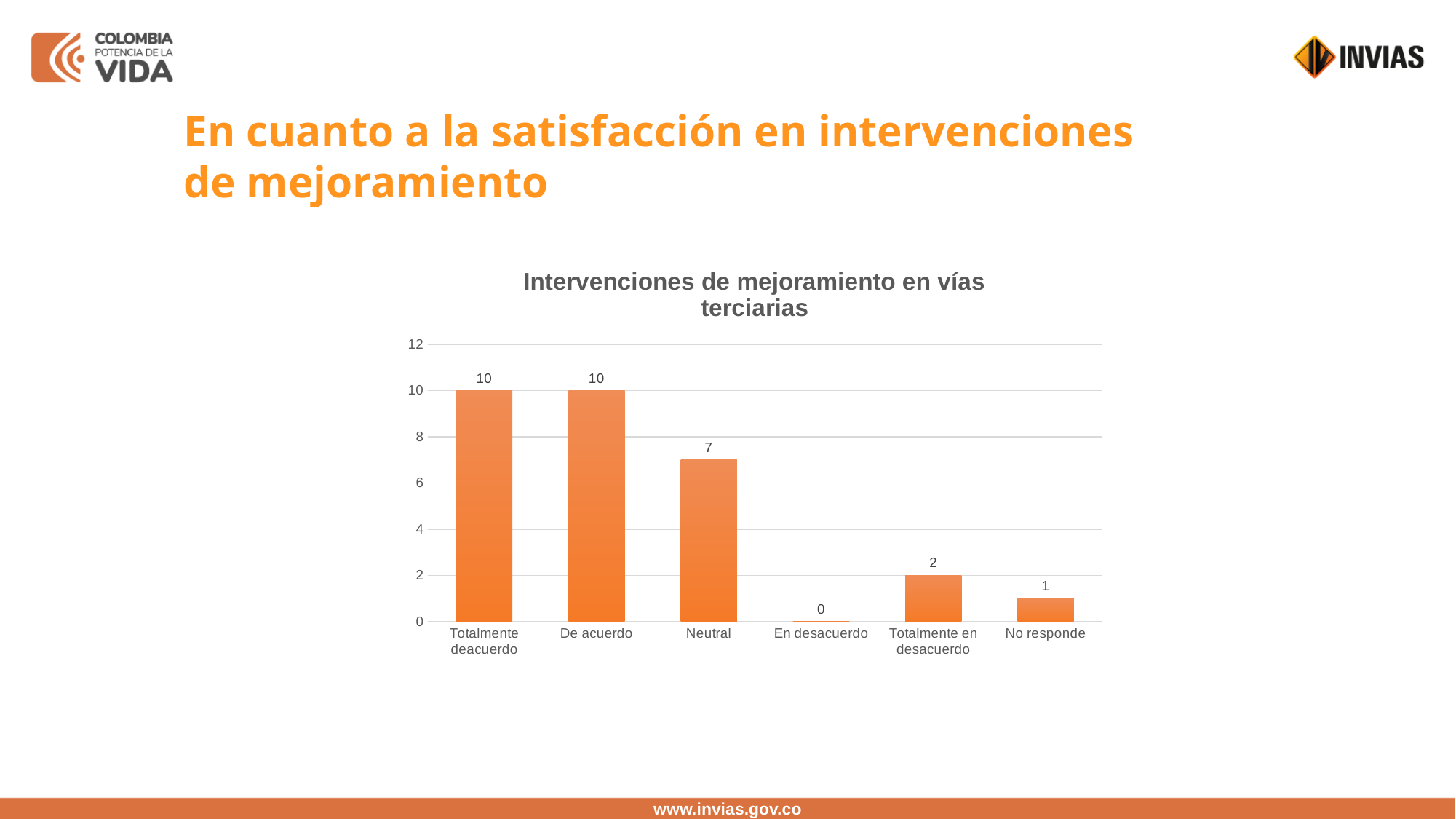
What is the value for En desacuerdo? 0 How many categories are shown on the x axis? 6 What is the value for No responde? 1 What is the value for Neutral? 7 What is the difference between the values for De acuerdo and Neutral? 3 Which is larger, the value for Neutral or the value for Totalmente en desacuerdo? Neutral What kind of chart is shown? Bar chart What is the title of the chart? Intervenciones de mejoramiento en vías terciarias Which category has the lowest value? En desacuerdo What is the highest value shown on the y axis? 12 What is the value for Totalmente en desacuerdo? 2 What is the difference between the values for Totalmente en desacuerdo and No responde? 1